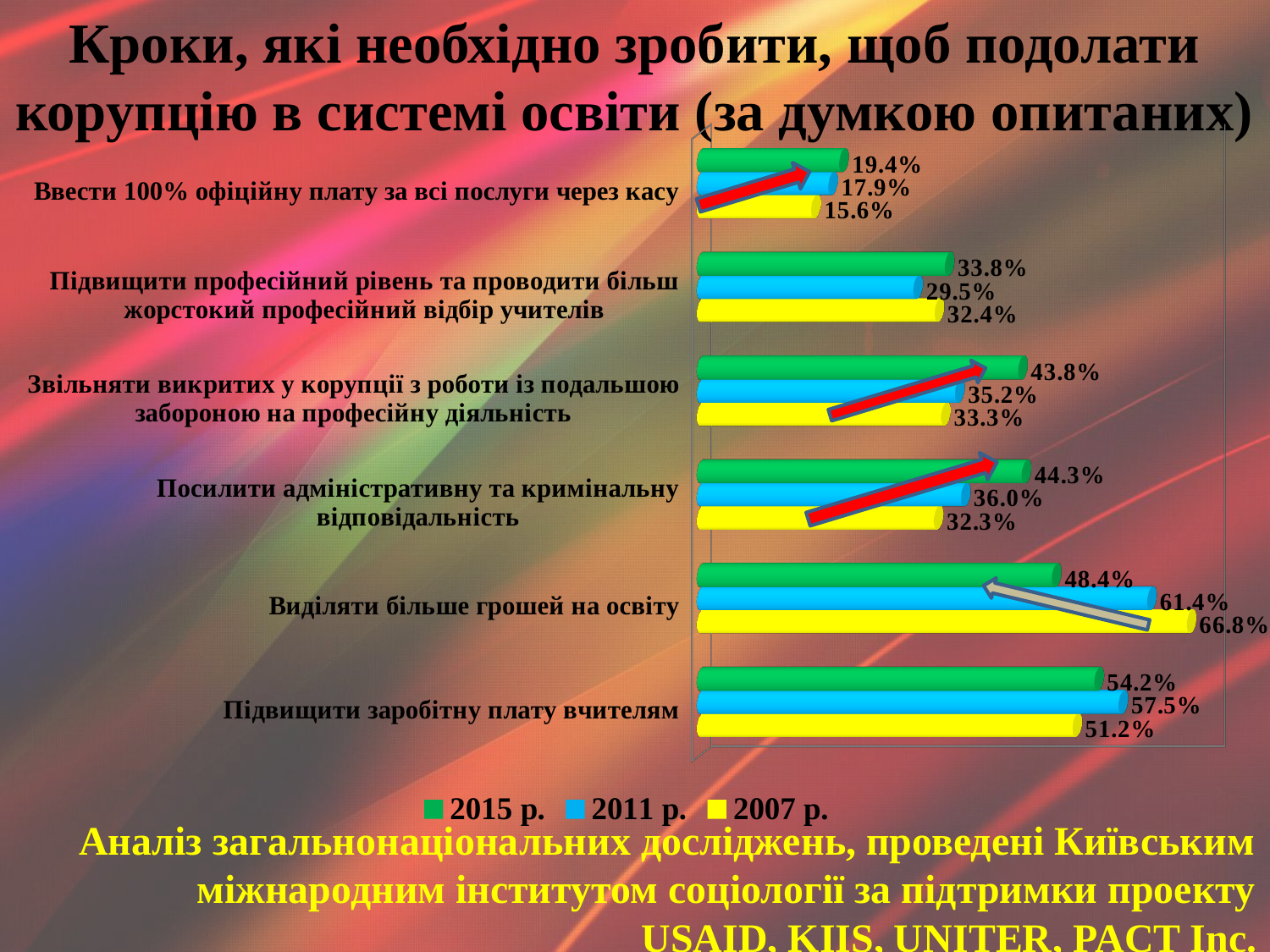
What is the 2011 р. value for "Посилити адміністративну та кримінальну відповідальність"? 36.0% How many categories are shown in the chart? 6 What kind of chart is shown on the slide? Bar chart Which colour represents the 2007 р. series in the legend? Yellow For "Звільняти викритих у корупції з роботи із подальшою забороною на професійну діяльність", which year has the larger value: 2015 р. or 2007 р.? 2015 р. Which category has the lowest 2015 р. value? Ввести 100% офіційну плату за всі послуги через касу How many series does the legend list? 3 What is the 2007 р. value for "Підвищити заробітну плату вчителям"? 51.2% What is the difference between the 2015 р. and 2011 р. values for "Підвищити професійний рівень та проводити більш жорстокий професійний відбір учителів"? 4.3% What is the difference between the 2007 р. and 2015 р. values for "Виділяти більше грошей на освіту"? 18.4% Which category has the highest 2007 р. value? Виділяти більше грошей на освіту What is the 2015 р. value for "Виділяти більше грошей на освіту"? 48.4%